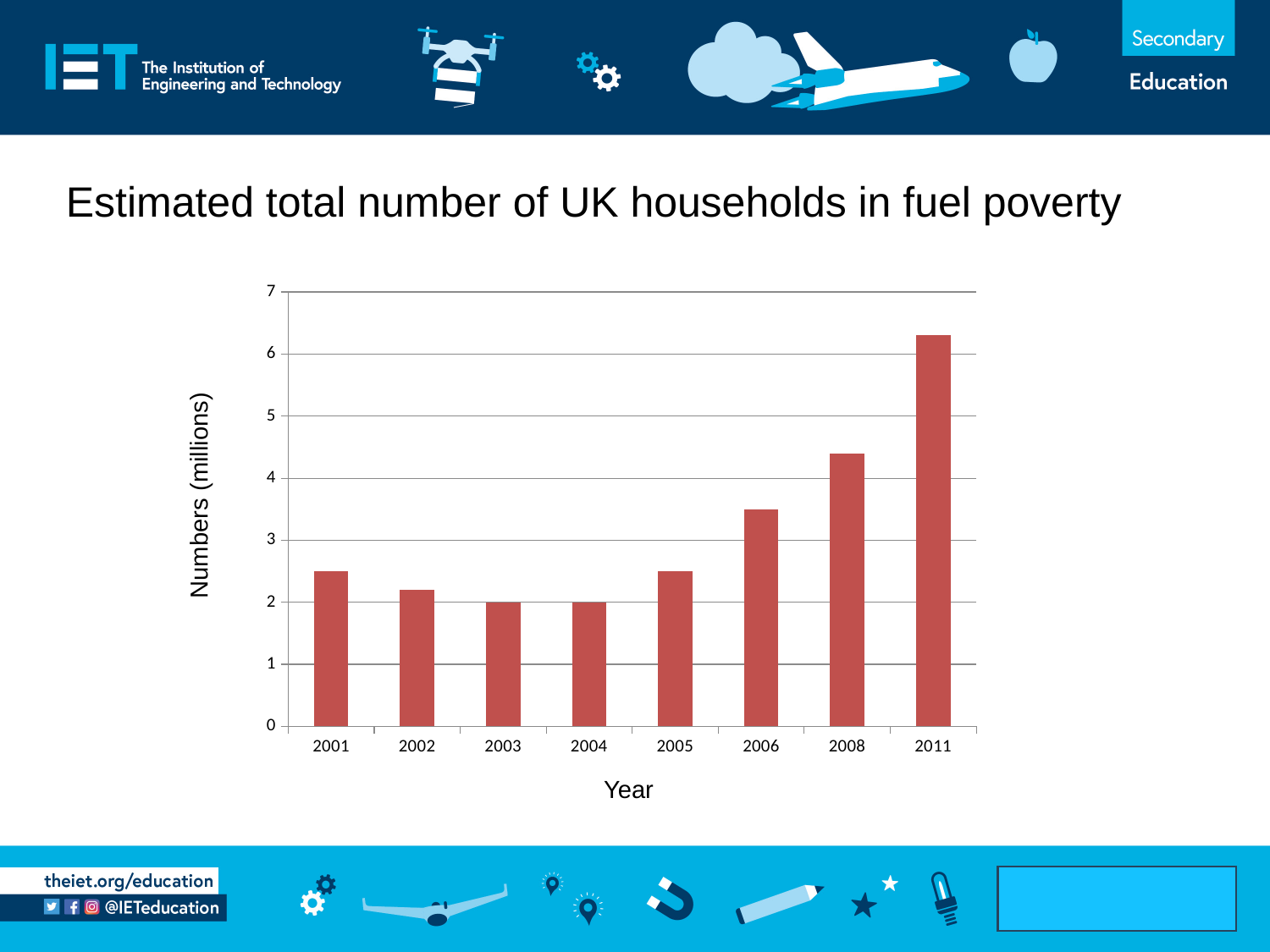
What is the title of the chart? Estimated total number of UK households in fuel poverty What is the label on the vertical axis of the chart? Numbers (millions) Is the value for 2011 greater or less than 6? greater Is the value for 2002 greater or less than 3? less What type of chart is shown on the slide? Bar chart Is the value for 2006 greater or less than 3? greater Which year has the highest estimated number of households in fuel poverty? 2011 Which is larger, the value for 2011 or the value for 2001? 2011 Do the values rise or fall from 2005 to 2011? rise How many years are shown on the x axis of the chart? 8